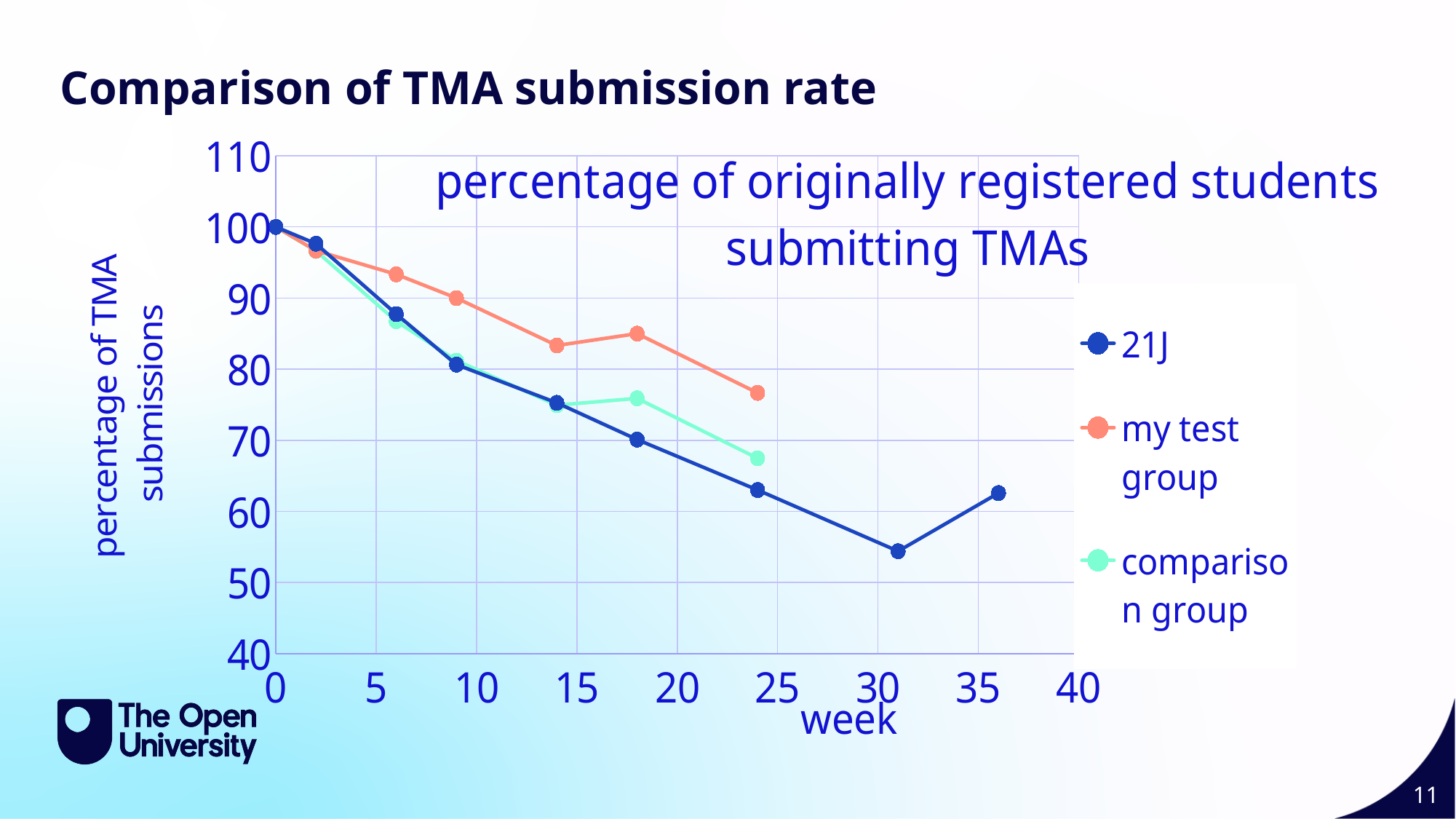
What is the label of the x axis? week Is the value for my test group at week 24 greater or less than 70? greater How many data points are plotted for the 21J series? 9 Which series has the highest value at week 24? my test group Does the my test group series generally rise or fall from week 0 to week 24? fall What is the value for 21J at week 0? 100 What kind of chart is shown on the slide? line chart Is the value for comparison group at week 24 greater or less than 70? less At week 24, which series has the higher value: my test group or comparison group? my test group How many series does the legend list? 3 Is the value for 21J at week 31 greater or less than 60? less What is the title of the chart? percentage of originally registered students submitting TMAs